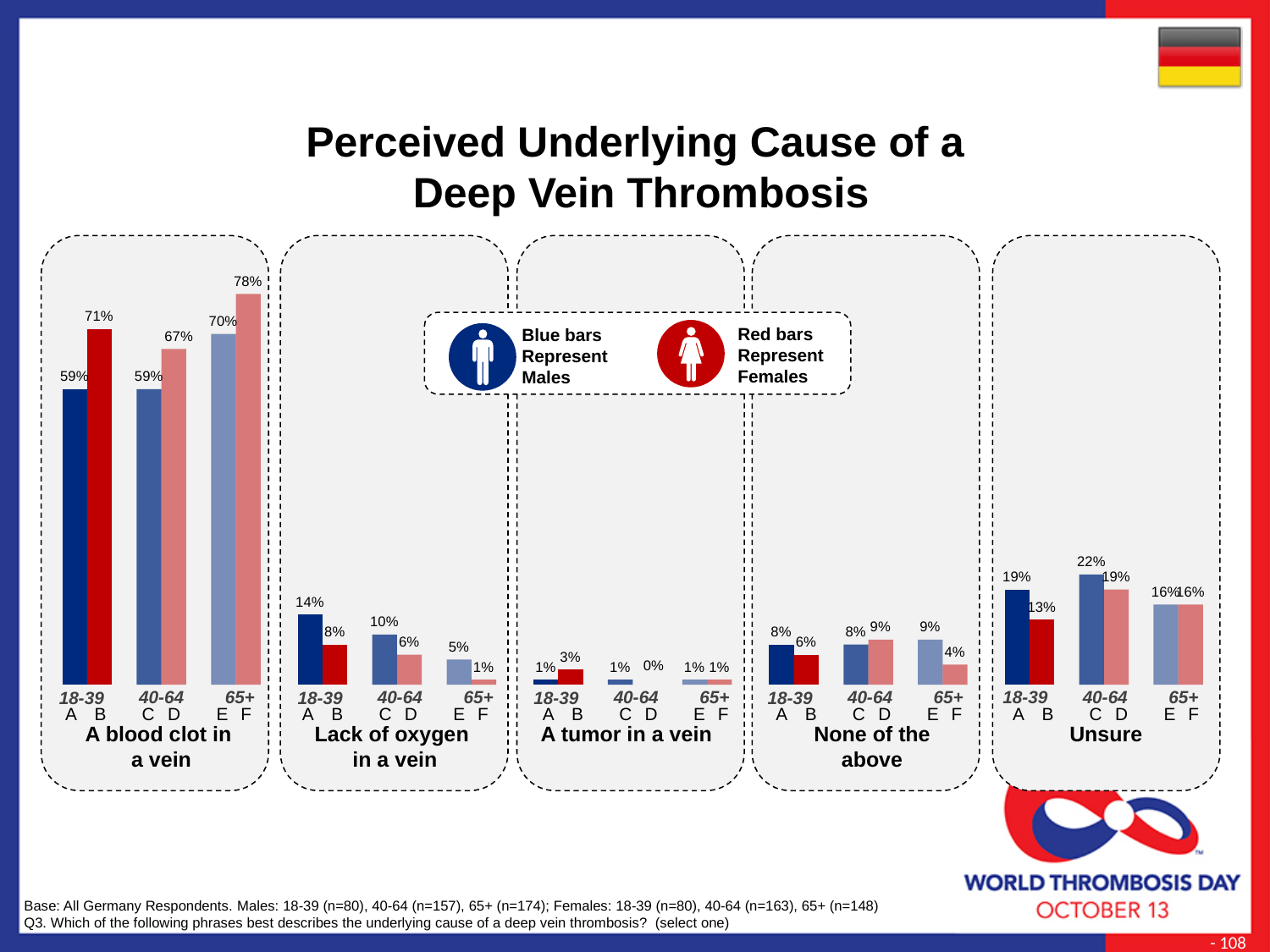
In the 'A tumor in a vein' chart, what is the value for females aged 40-64? 0% In the 'Unsure' chart, what is the value for males aged 40-64? 22% In the 'A blood clot in a vein' chart, do the female values rise or fall from the 18-39 group to the 65+ group? Rise According to the legend, what do the red bars represent? Females In the 'Lack of oxygen in a vein' chart, which age-gender bar is the highest? Males 18-39 (14%) How many age groups are shown in each chart? 3 In the 'A blood clot in a vein' chart, what is the value for males aged 18-39? 59% In the 'None of the above' chart, which is larger: males aged 65+ or females aged 65+? Males aged 65+ (9%) What type of chart is used on this slide? Bar chart In the 'Unsure' chart, what is the difference between males and females aged 18-39? 6% In the 'A blood clot in a vein' chart, what is the value for females aged 65+? 78% In the 'Lack of oxygen in a vein' chart, what is the difference between males and females aged 18-39? 6%